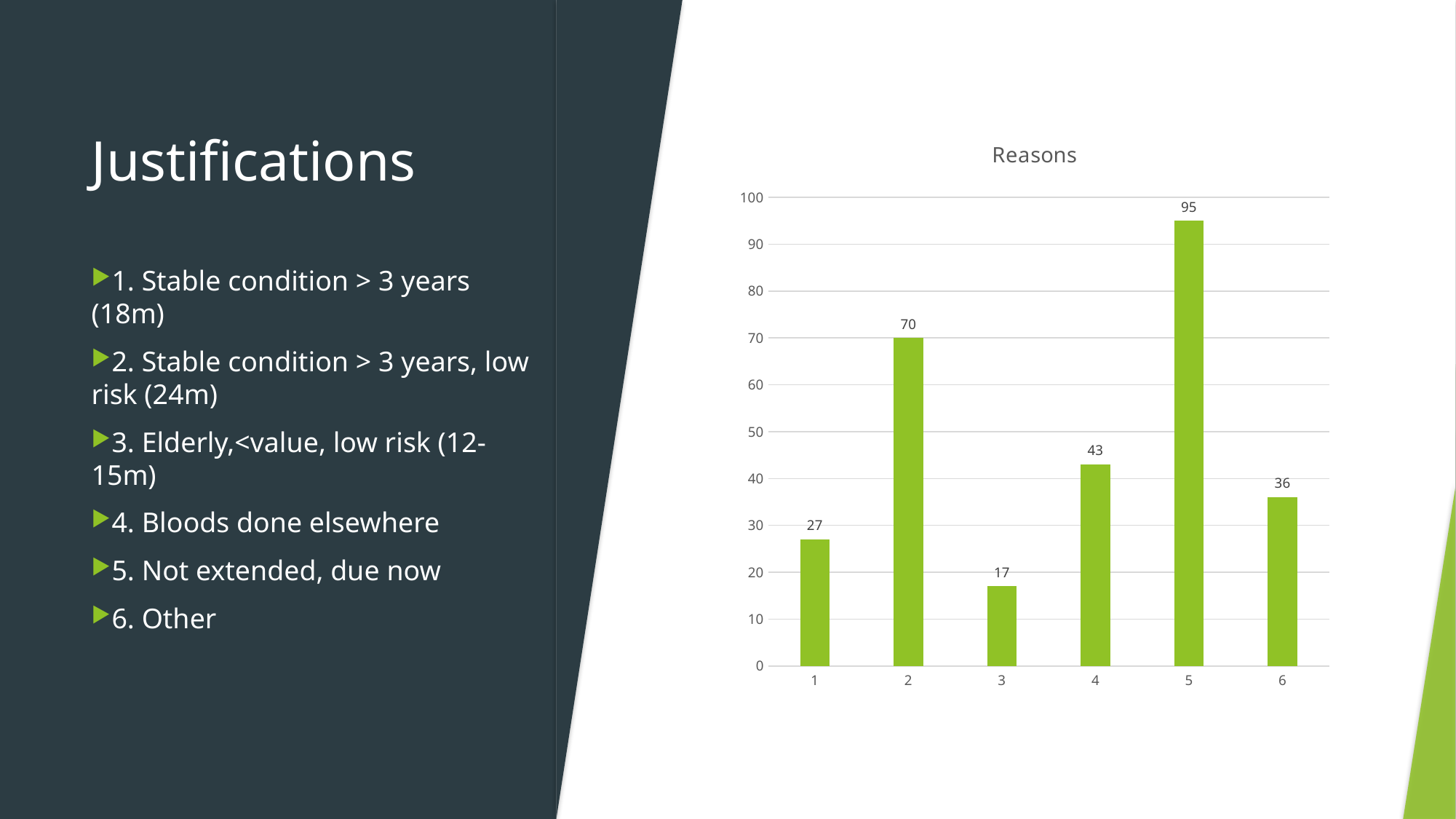
What is the value for category 1 in the Reasons chart? 27 What kind of chart is shown on the slide? Bar chart Which category has the lowest value in the Reasons chart? 3 What is the difference between the values for category 4 and category 6? 7 What is the title of the chart on the slide? Reasons Is the value for category 6 greater or less than 40? less How many categories are shown on the x axis of the Reasons chart? 6 What is the difference between the values for category 5 and category 2? 25 What is the value for category 3 in the Reasons chart? 17 What is the value for category 5 in the Reasons chart? 95 Which is larger, the value for category 2 or the value for category 4? Category 2 Which category has the highest value in the Reasons chart? 5